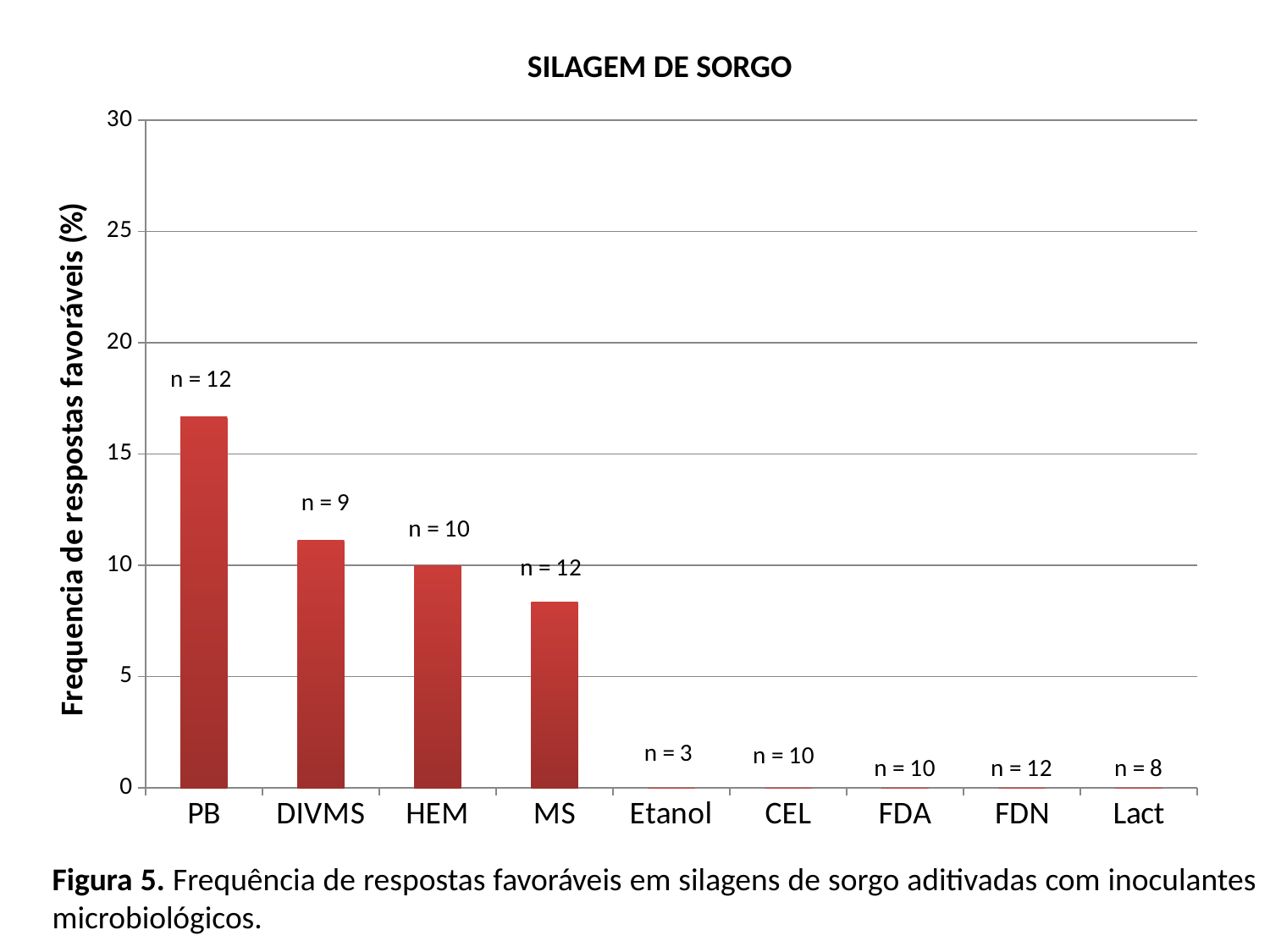
What is the n value labelled for Etanol? n = 3 What is the n value labelled above the PB bar? n = 12 What is the title of the chart? SILAGEM DE SORGO Is the value for DIVMS greater or less than 10? greater Which is larger, the value for PB or the value for DIVMS? PB How many categories are shown on the x axis of the chart? 9 Is the value for MS greater or less than 10? less Is the value for PB greater or less than 15? greater Which category has the highest frequency of favourable responses? PB What is the frequency of favourable responses (%) for Etanol? 0 What kind of chart is shown on the slide? bar chart What is the frequency of favourable responses (%) for HEM? 10